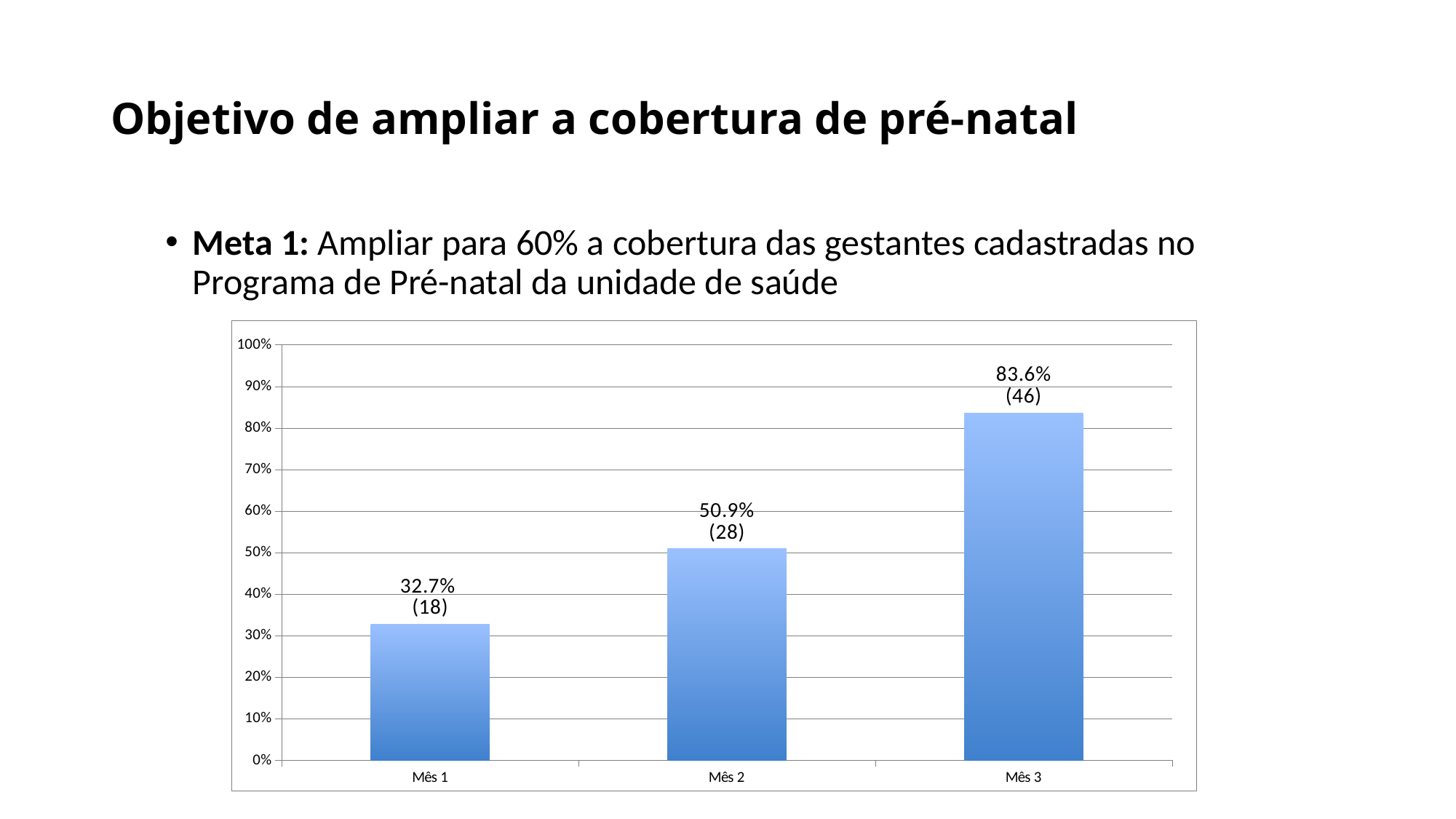
Which month has the highest value? Mês 3 Is the value for Mês 2 greater or less than 60%? less What is the value for Mês 3? 83.6% What kind of chart is shown? bar chart What count is shown in parentheses for Mês 3? 46 Which is larger, the value for Mês 2 or Mês 1? Mês 2 What is the value for Mês 1? 32.7% What is the value for Mês 2? 50.9% Which month has the lowest value? Mês 1 Do the values rise or fall from Mês 1 to Mês 3? rise How many months are shown on the x axis? 3 What is the difference in percentage points between Mês 3 and Mês 1? 50.9